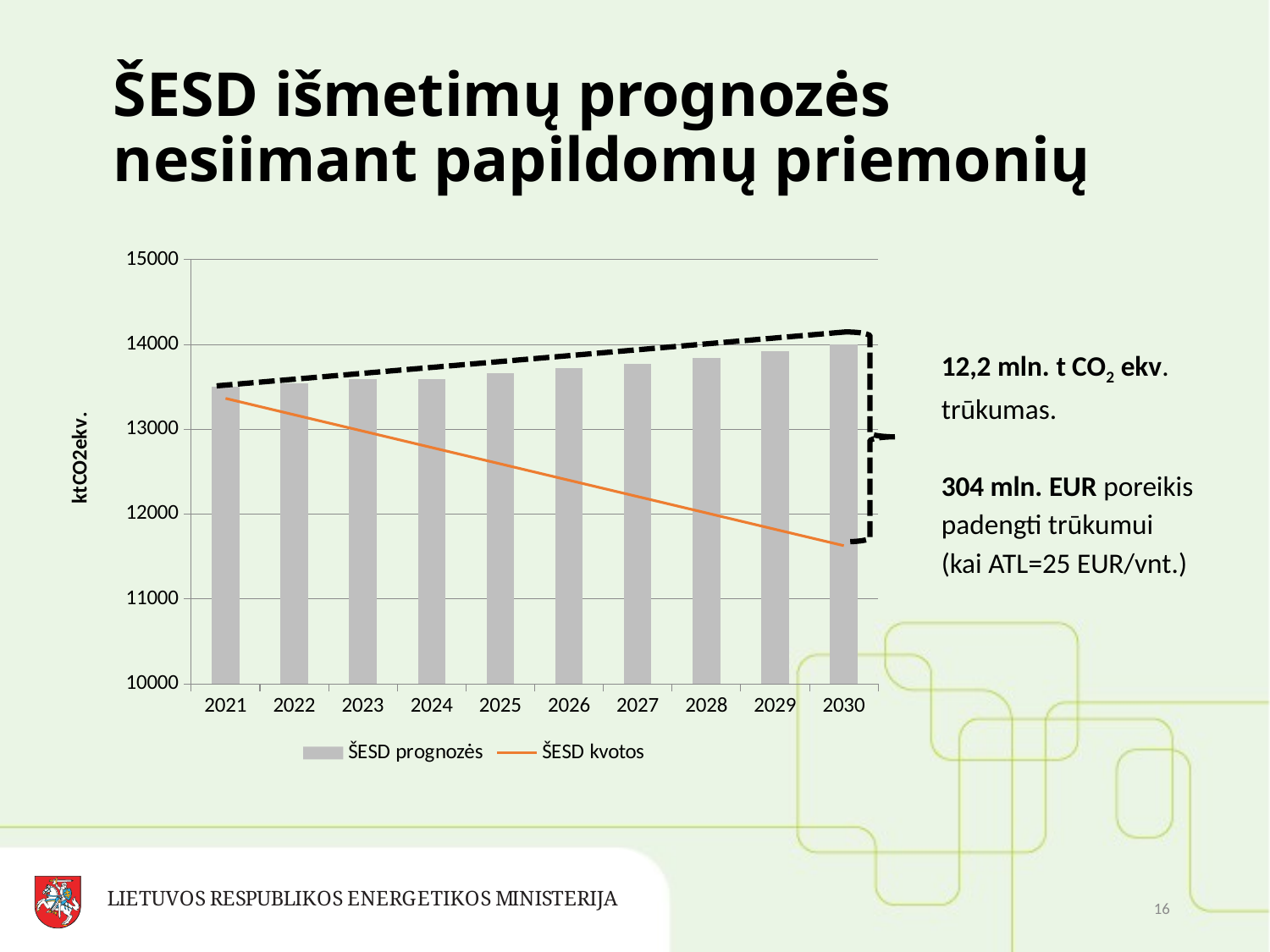
How many years are shown on the x axis of the chart? 10 Is the ŠESD kvotos value for 2030 greater or less than 12000? less Do the ŠESD prognozės bars rise or fall from 2021 to 2030? Rise How many series does the chart legend list? 2 Does the ŠESD kvotos line rise or fall from 2021 to 2030? Fall What are the two series named in the chart legend? ŠESD prognozės and ŠESD kvotos In 2030, which is larger: the ŠESD prognozės bar or the ŠESD kvotos line value? ŠESD prognozės What is the label on the vertical axis of the chart? ktCO2ekv. Is the ŠESD prognozės value for 2030 greater or less than 13000? greater Which year has the lowest ŠESD prognozės bar? 2021 What kind of chart is shown on the slide? A bar chart with a line series Which year has the highest ŠESD prognozės bar? 2030